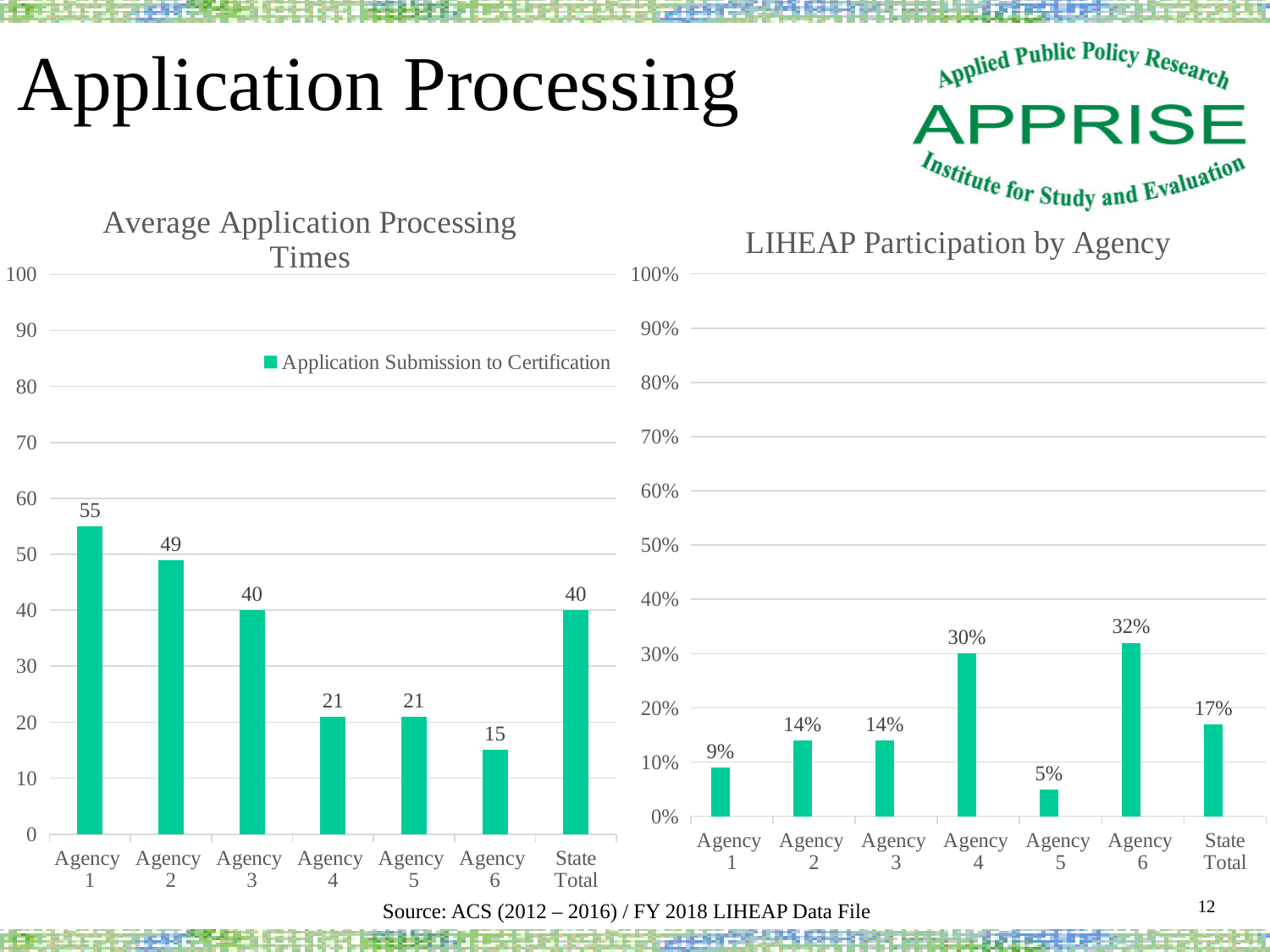
In the 'LIHEAP Participation by Agency' chart, what is the value for Agency 6? 32% In the 'Average Application Processing Times' chart, what is the value for State Total? 40 In the 'Average Application Processing Times' chart, what is the difference between Agency 1 and Agency 2? 6 In the 'LIHEAP Participation by Agency' chart, which agency has the highest participation? Agency 6 In the 'Average Application Processing Times' chart, what is the value for Agency 1? 55 In the 'Average Application Processing Times' chart, what series does the legend list? Application Submission to Certification In the 'Average Application Processing Times' chart, which agency has the lowest processing time? Agency 6 What kind of chart is the 'LIHEAP Participation by Agency' chart? Bar chart In the 'LIHEAP Participation by Agency' chart, what is the difference between Agency 6 and Agency 4? 2% In the 'LIHEAP Participation by Agency' chart, which is larger, the value for Agency 4 or the value for State Total? Agency 4 In the 'LIHEAP Participation by Agency' chart, which agency has the lowest participation? Agency 5 In the 'Average Application Processing Times' chart, how many categories are shown on the x axis? 7